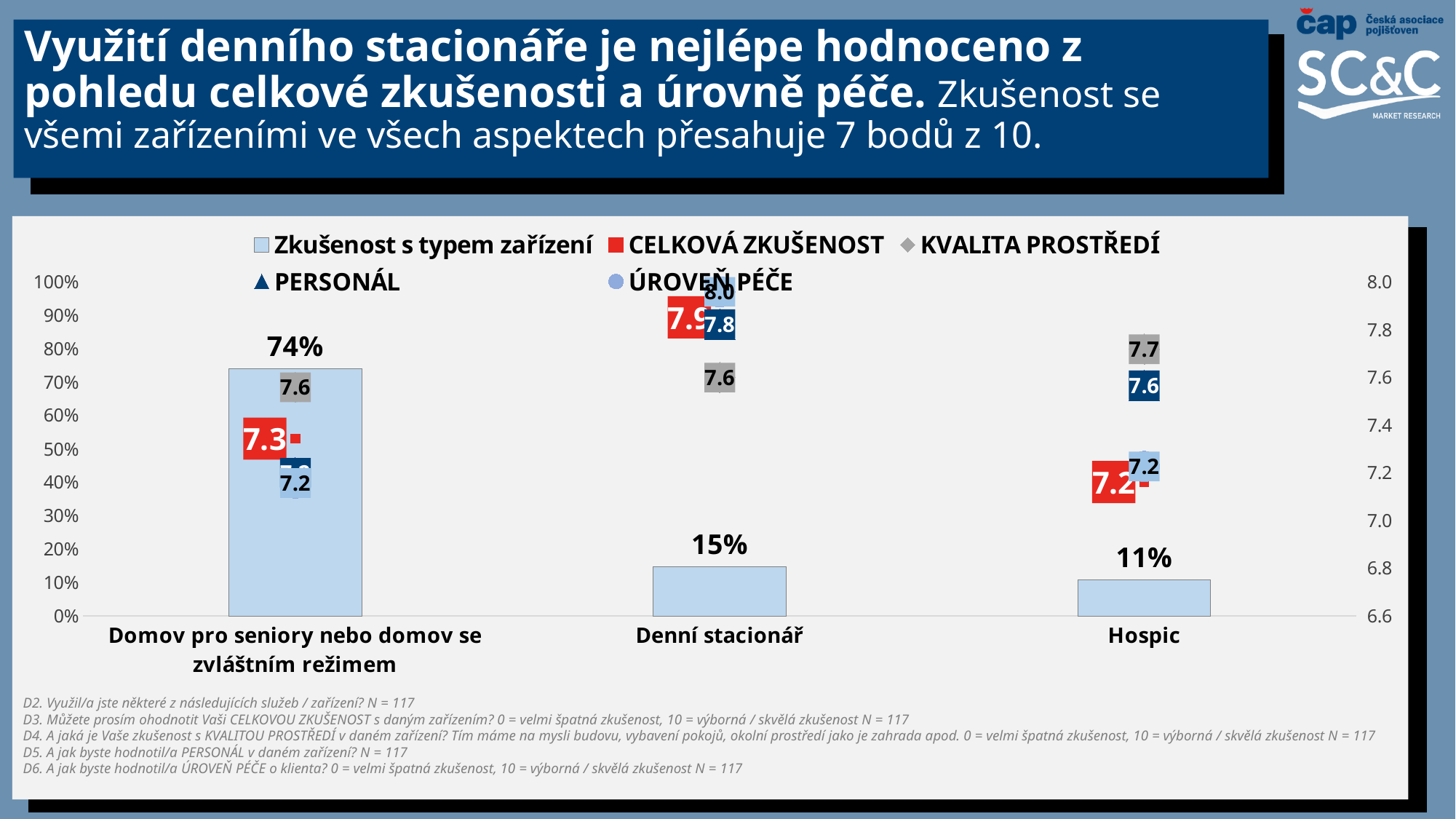
How many categories are shown on the x axis? 3 What percentage is shown for Hospic in the Zkušenost s typem zařízení series? 11% How many series does the legend list? 5 Which category has the highest value in the Zkušenost s typem zařízení series? Domov pro seniory nebo domov se zvláštním režimem Which category has the lowest value in the Zkušenost s typem zařízení series? Hospic What is the KVALITA PROSTŘEDÍ rating for Hospic? 7.7 What is the CELKOVÁ ZKUŠENOST rating for Hospic? 7.2 What is the ÚROVEŇ PÉČE rating for Denní stacionář? 8.0 What percentage is shown for Domov pro seniory nebo domov se zvláštním režimem in the Zkušenost s typem zařízení series? 74% What is the difference between the Zkušenost s typem zařízení values for Denní stacionář and Hospic? 4% Which category has the highest CELKOVÁ ZKUŠENOST rating? Denní stacionář What is the CELKOVÁ ZKUŠENOST rating for Denní stacionář? 7.9